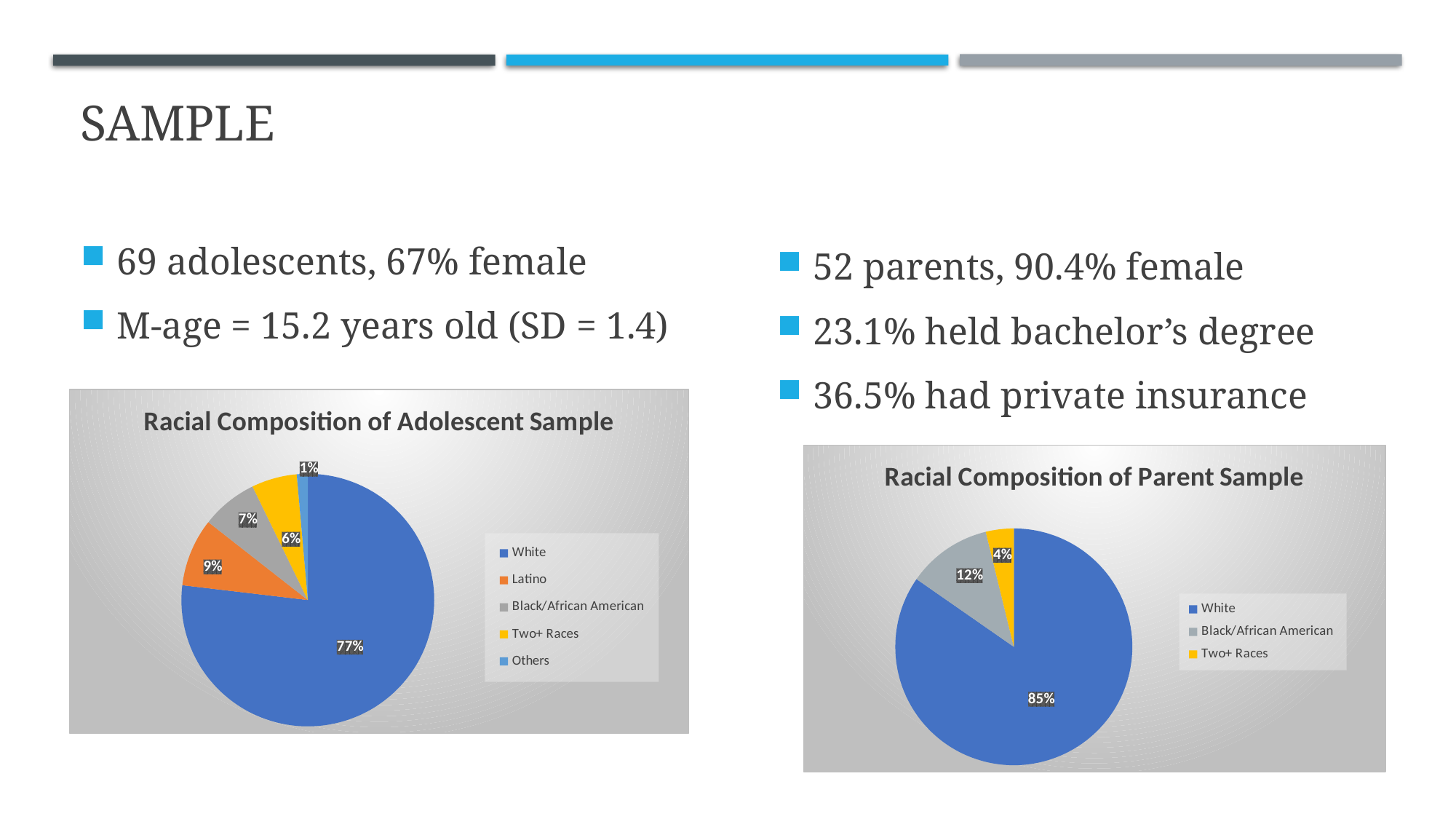
In the 'Racial Composition of Adolescent Sample' chart, what percentage is Latino? 9% In the 'Racial Composition of Adolescent Sample' chart, what share of the pie is White? 77% In the 'Racial Composition of Parent Sample' chart, what percentage is Black/African American? 12% What type of chart is the 'Racial Composition of Parent Sample' chart? Pie chart In the 'Racial Composition of Parent Sample' chart, how many categories does the legend list? 3 In the 'Racial Composition of Adolescent Sample' chart, which category has the smallest slice? Others In the 'Racial Composition of Adolescent Sample' chart, how many categories does the legend list? 5 In the 'Racial Composition of Parent Sample' chart, which category has the largest slice? White In the 'Racial Composition of Parent Sample' chart, what share of the pie is White? 85% In the 'Racial Composition of Adolescent Sample' chart, what percentage is Black/African American? 7% In the 'Racial Composition of Adolescent Sample' chart, what is the difference between the Latino and Two+ Races percentages? 3% Which is larger: the Two+ Races share in the Adolescent Sample chart or the Two+ Races share in the Parent Sample chart? Adolescent Sample (6%)